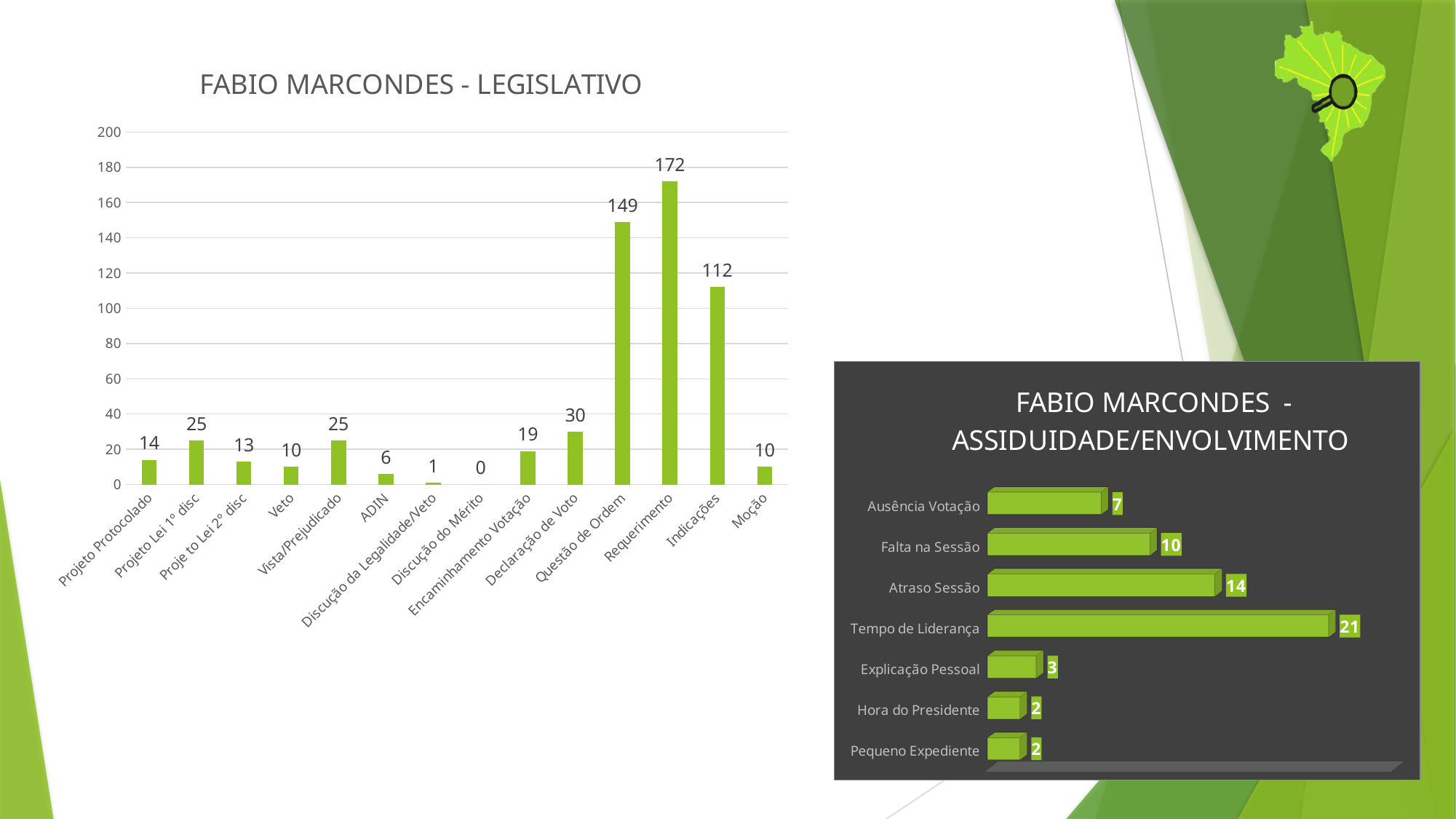
In the 'FABIO MARCONDES - LEGISLATIVO' chart, what is the value for Requerimento? 172 In the 'FABIO MARCONDES - ASSIDUIDADE/ENVOLVIMENTO' chart, what is the value for Tempo de Liderança? 21 What kind of chart is 'FABIO MARCONDES - LEGISLATIVO'? Bar chart In the 'FABIO MARCONDES - LEGISLATIVO' chart, which category has the highest value? Requerimento In the 'FABIO MARCONDES - ASSIDUIDADE/ENVOLVIMENTO' chart, which category has the highest value? Tempo de Liderança How many categories are shown in the 'FABIO MARCONDES - LEGISLATIVO' chart? 14 In the 'FABIO MARCONDES - LEGISLATIVO' chart, which is larger, Indicações or Questão de Ordem? Questão de Ordem In the 'FABIO MARCONDES - LEGISLATIVO' chart, what is the difference between Requerimento and Questão de Ordem? 23 In the 'FABIO MARCONDES - LEGISLATIVO' chart, what is the value for Declaração de Voto? 30 How many categories are shown in the 'FABIO MARCONDES - ASSIDUIDADE/ENVOLVIMENTO' chart? 7 In the 'FABIO MARCONDES - ASSIDUIDADE/ENVOLVIMENTO' chart, what is the difference between Atraso Sessão and Falta na Sessão? 4 In the 'FABIO MARCONDES - LEGISLATIVO' chart, which category has the lowest value? Discução do Mérito